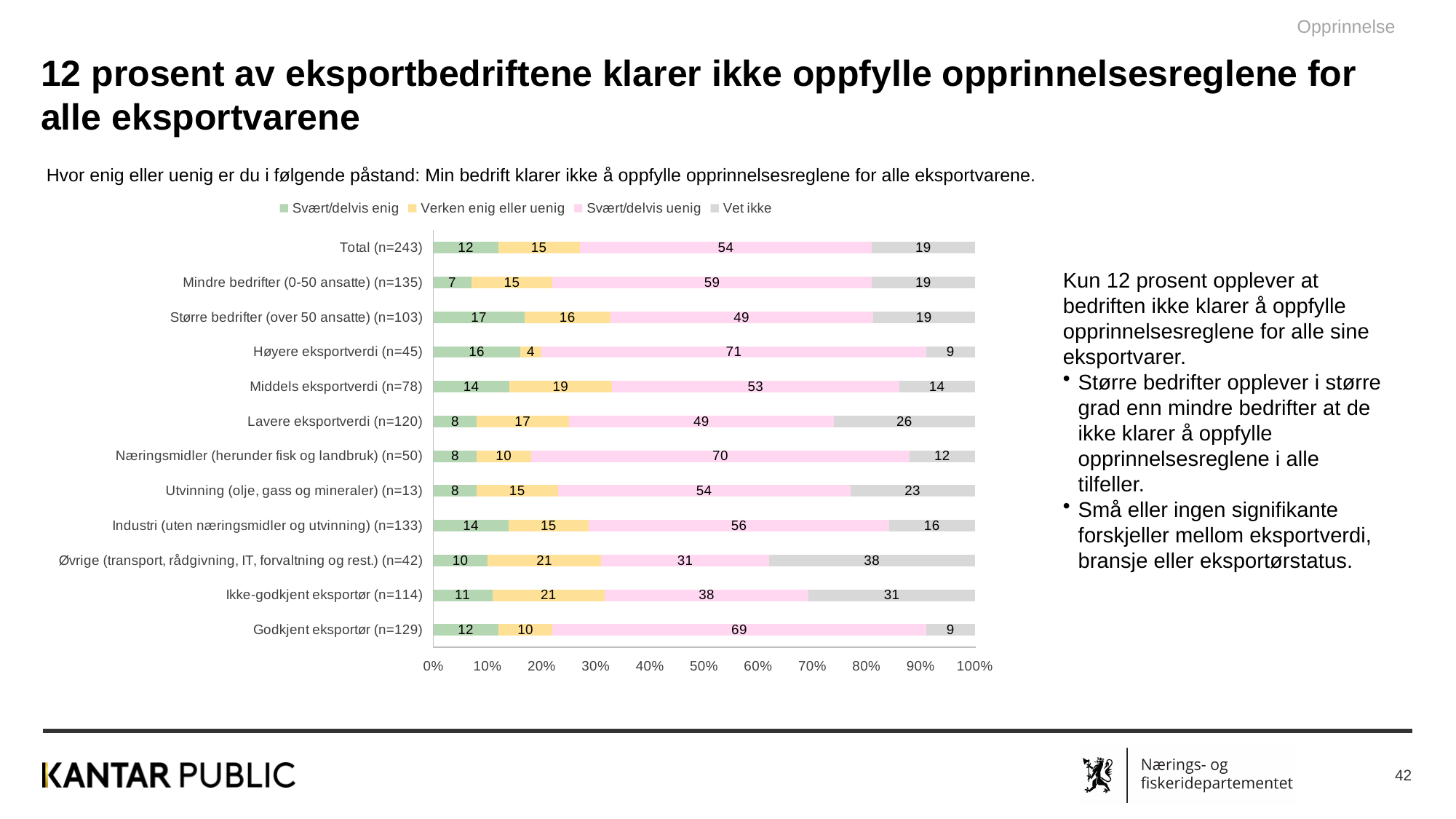
What is the value for Svært/delvis uenig in the Høyere eksportverdi (n=45) bar? 71 Which category has the highest Svært/delvis enig value? Større bedrifter (over 50 ansatte) (n=103) Which category has the lowest Svært/delvis enig value? Mindre bedrifter (0-50 ansatte) (n=135) Which has a larger Vet ikke value: Lavere eksportverdi (n=120) or Utvinning (olje, gass og mineraler) (n=13)? Lavere eksportverdi (n=120) Which category has the highest Vet ikke value? Øvrige (transport, rådgivning, IT, forvaltning og rest.) (n=42) What is the difference between the Svært/delvis uenig values for Mindre bedrifter (0-50 ansatte) and Større bedrifter (over 50 ansatte)? 10 What kind of chart is shown on the slide? Stacked bar chart What is the Vet ikke value for Øvrige (transport, rådgivning, IT, forvaltning og rest.) (n=42)? 38 What is the Verken enig eller uenig value for Ikke-godkjent eksportør (n=114)? 21 How many series does the legend list? 4 What is the total of the Total (n=243) bar? 100 How many categories (bars) are shown in the chart? 12